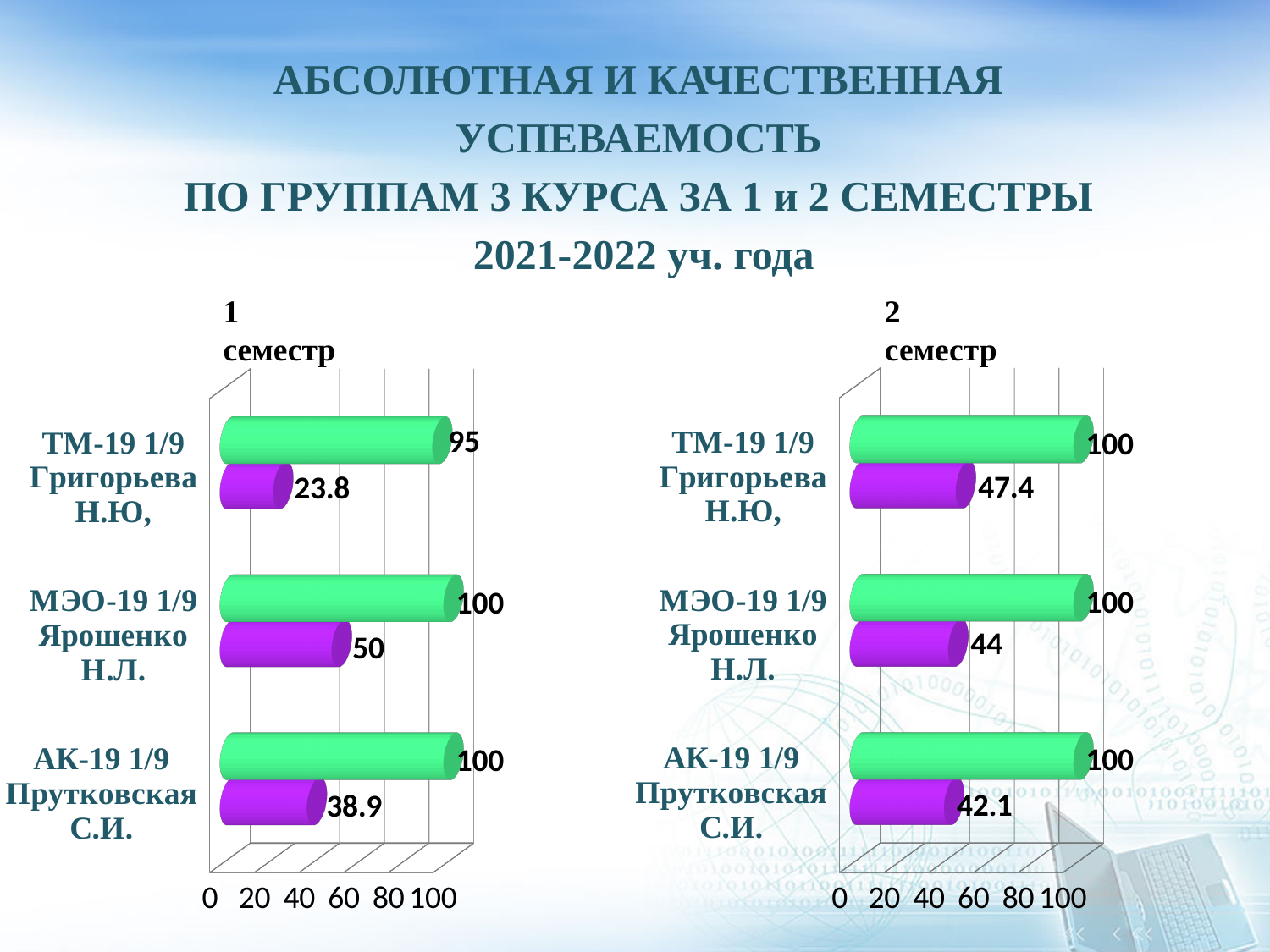
In the "2 семестр" chart, what is the difference between the purple bar values for ТМ-19 1/9 Григорьева Н.Ю. and МЭО-19 1/9 Ярошенко Н.Л.? 3.4 In the "1 семестр" chart, is the purple bar value for ТМ-19 1/9 Григорьева Н.Ю. greater or less than 40? less How many groups are shown in the "2 семестр" chart? 3 In the "2 семестр" chart, which group has the highest purple bar value? ТМ-19 1/9 Григорьева Н.Ю. In the "1 семестр" chart, what is the value of the green bar for ТМ-19 1/9 Григорьева Н.Ю.? 95 In the "1 семестр" chart, which group has the lowest purple bar value? ТМ-19 1/9 Григорьева Н.Ю. In the "1 семестр" chart, what is the difference between the green and purple bar values for АК-19 1/9 Прутковская С.И.? 61.1 In the "1 семестр" chart, which is larger: the purple bar for МЭО-19 1/9 Ярошенко Н.Л. or the purple bar for АК-19 1/9 Прутковская С.И.? МЭО-19 1/9 Ярошенко Н.Л. In the "2 семестр" chart, what is the value of the purple bar for АК-19 1/9 Прутковская С.И.? 42.1 In the "1 семестр" chart, what is the value of the purple bar for МЭО-19 1/9 Ярошенко Н.Л.? 50 What type of chart is the "1 семестр" chart? Bar chart In the "2 семестр" chart, what is the value of the purple bar for ТМ-19 1/9 Григорьева Н.Ю.? 47.4